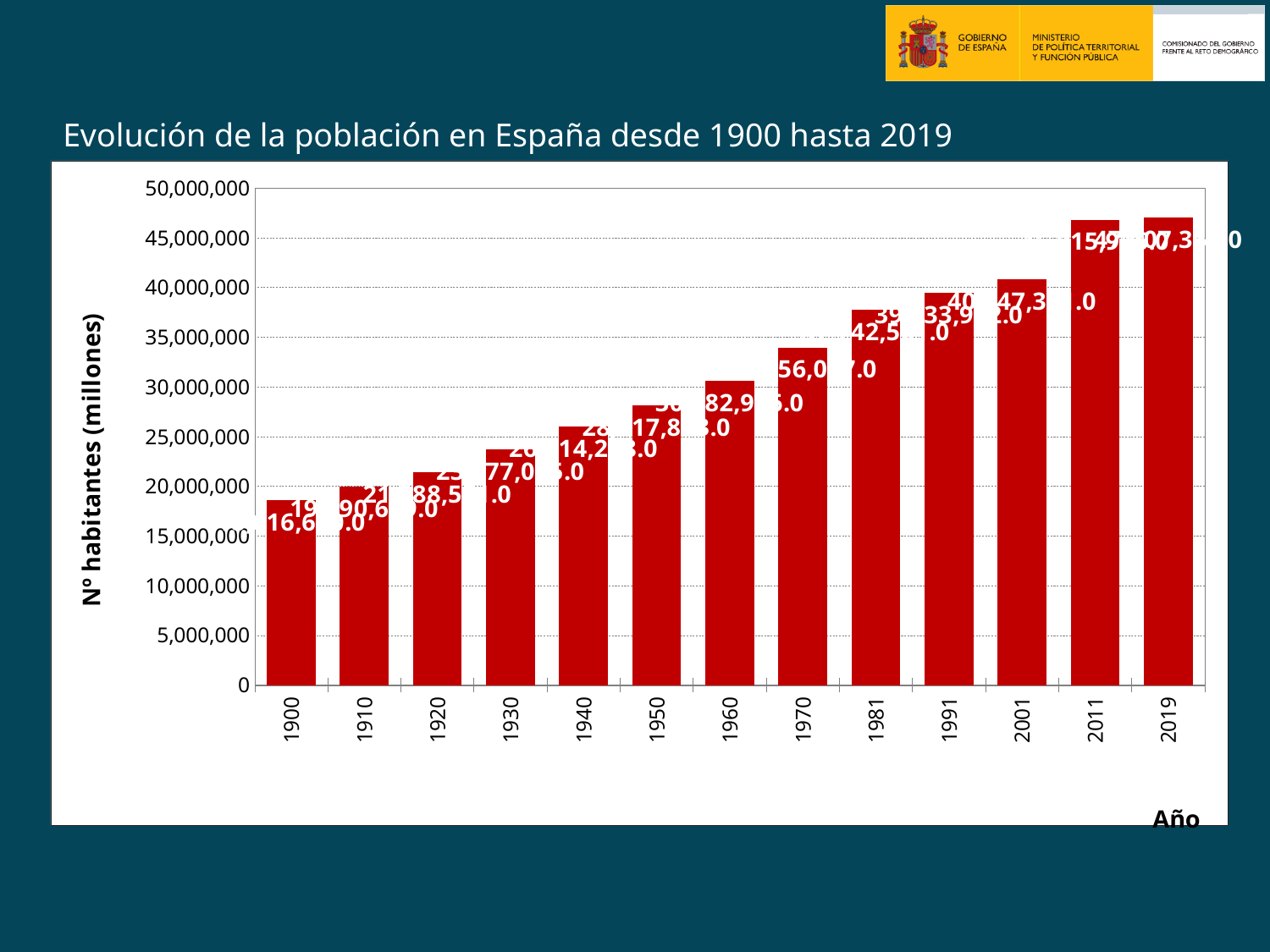
Which is larger, the population in 1970 or in 1950? 1970 Is the value for 1950 greater or less than 30,000,000? less What is the title of the chart? Evolución de la población en España desde 1900 hasta 2019 Do the population values generally rise or fall from 1900 to 2019? rise What kind of chart is shown on the slide? bar chart What is the label of the vertical axis? Nº habitantes (millones) How many years (bars) are plotted in the chart? 13 Is the value for 1900 greater or less than 15,000,000? greater Is the value for 1981 greater or less than 35,000,000? greater Which year has the lowest population in the chart? 1900